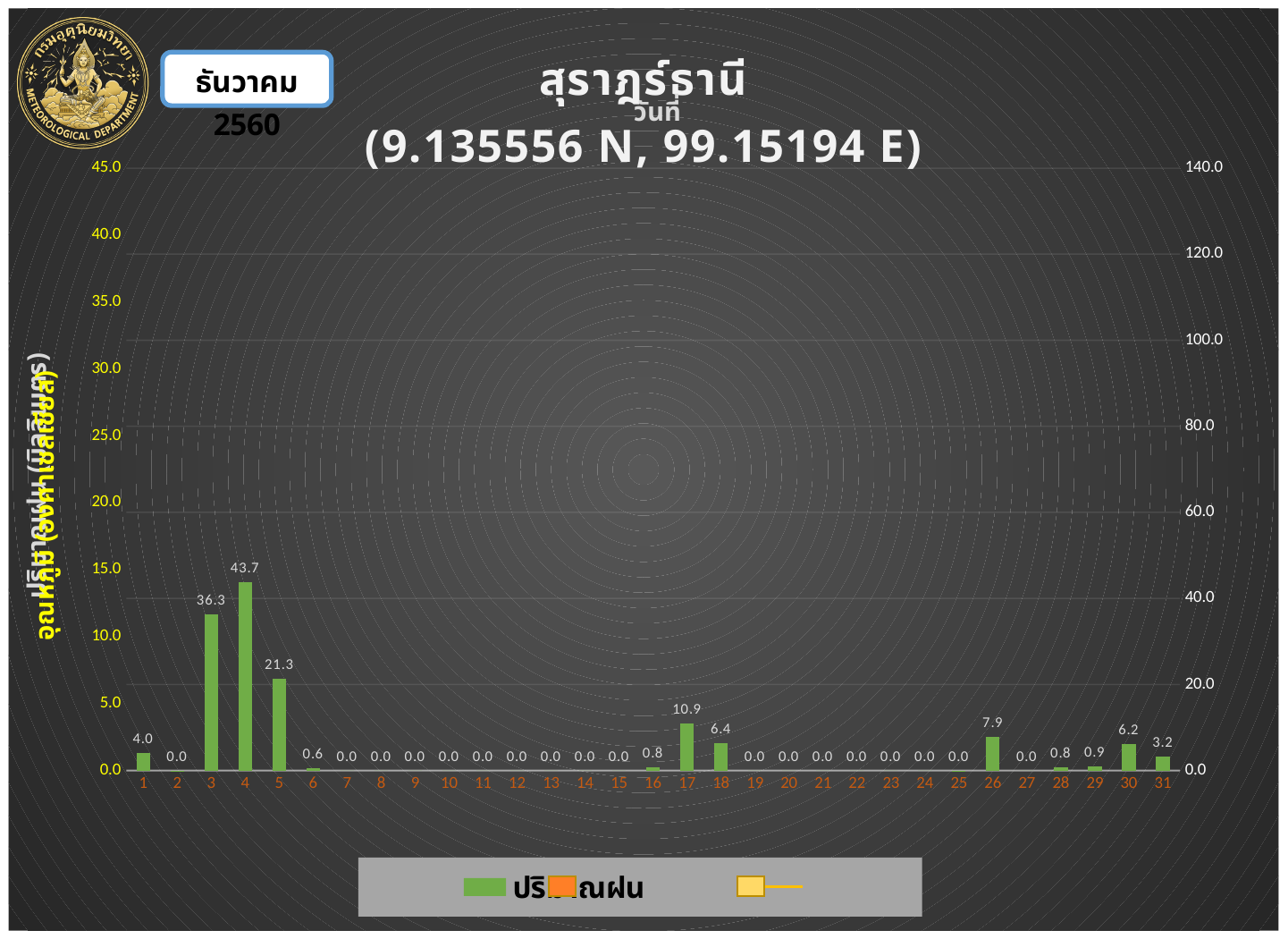
What is the rainfall value for day 4? 43.7 What is the difference between the rainfall values for day 4 and day 3? 7.4 Which day has the highest rainfall value? 4 What kind of chart is shown on the slide? bar chart Which has a larger rainfall value, day 5 or day 30? day 5 What is the rainfall value for day 1? 4.0 What coordinates are given in the chart title? (9.135556 N, 99.15194 E) What is the difference between the rainfall values for day 17 and day 18? 4.5 What is the rainfall value for day 26? 7.9 What is the rainfall value for day 17? 10.9 What is the lowest rainfall value shown on the chart? 0.0 How many days are shown on the x axis of the chart? 31